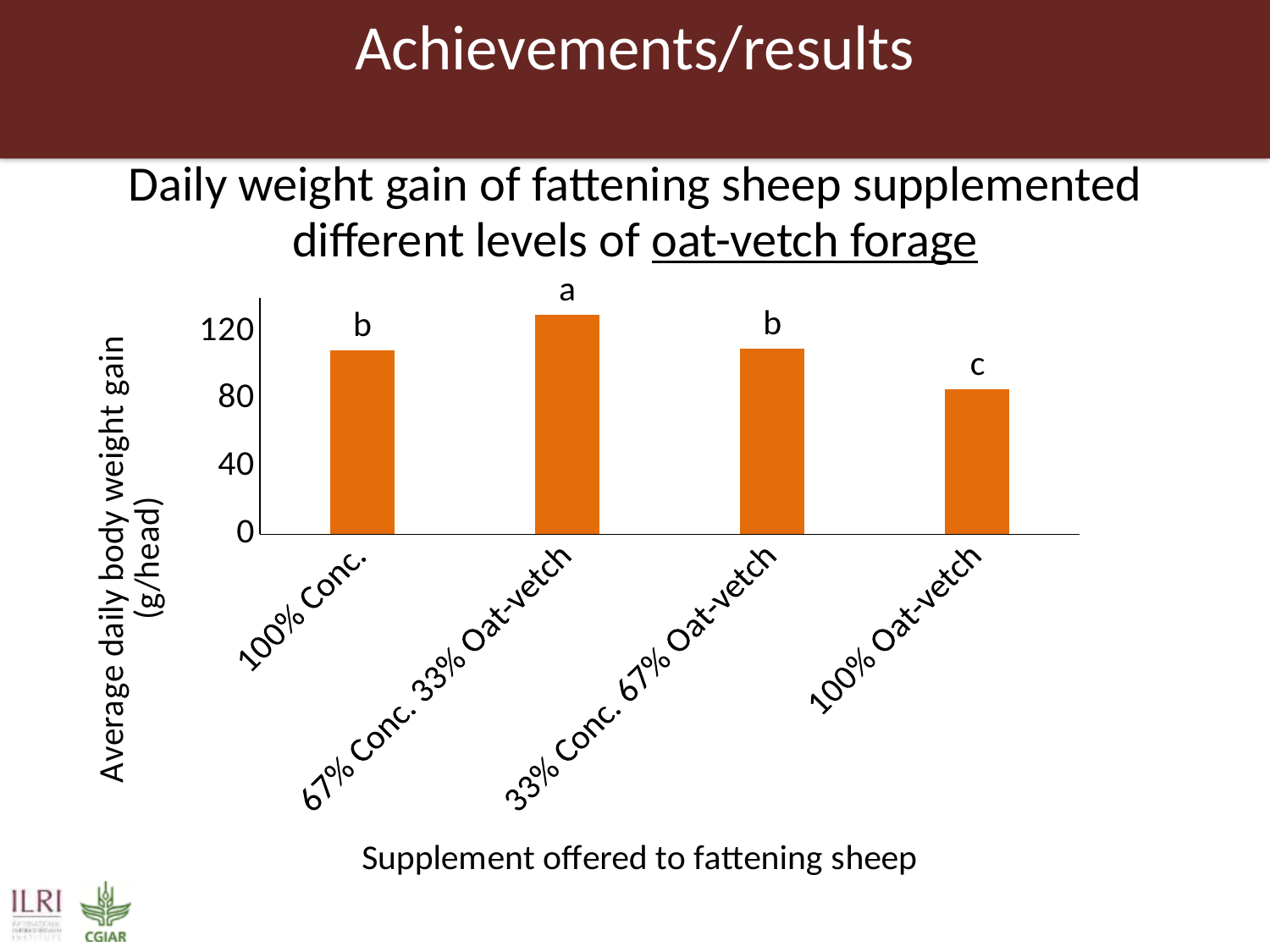
What letter is printed above the bar for 100% Oat-vetch? c Is the value for 67% Conc. 33% Oat-vetch greater or less than 120? greater Which supplement gives the lowest average daily body weight gain? 100% Oat-vetch What is the label of the y axis of the chart? Average daily body weight gain (g/head) Is the value for 100% Oat-vetch greater or less than 120? less Which has the larger average daily body weight gain, 100% Conc. or 100% Oat-vetch? 100% Conc. Which supplement gives the highest average daily body weight gain? 67% Conc. 33% Oat-vetch Is the value for 33% Conc. 67% Oat-vetch greater or less than 120? less Which has the larger average daily body weight gain, 100% Oat-vetch or 67% Conc. 33% Oat-vetch? 67% Conc. 33% Oat-vetch How many supplement categories are plotted on the x axis? 4 What kind of chart is shown on the slide? bar chart